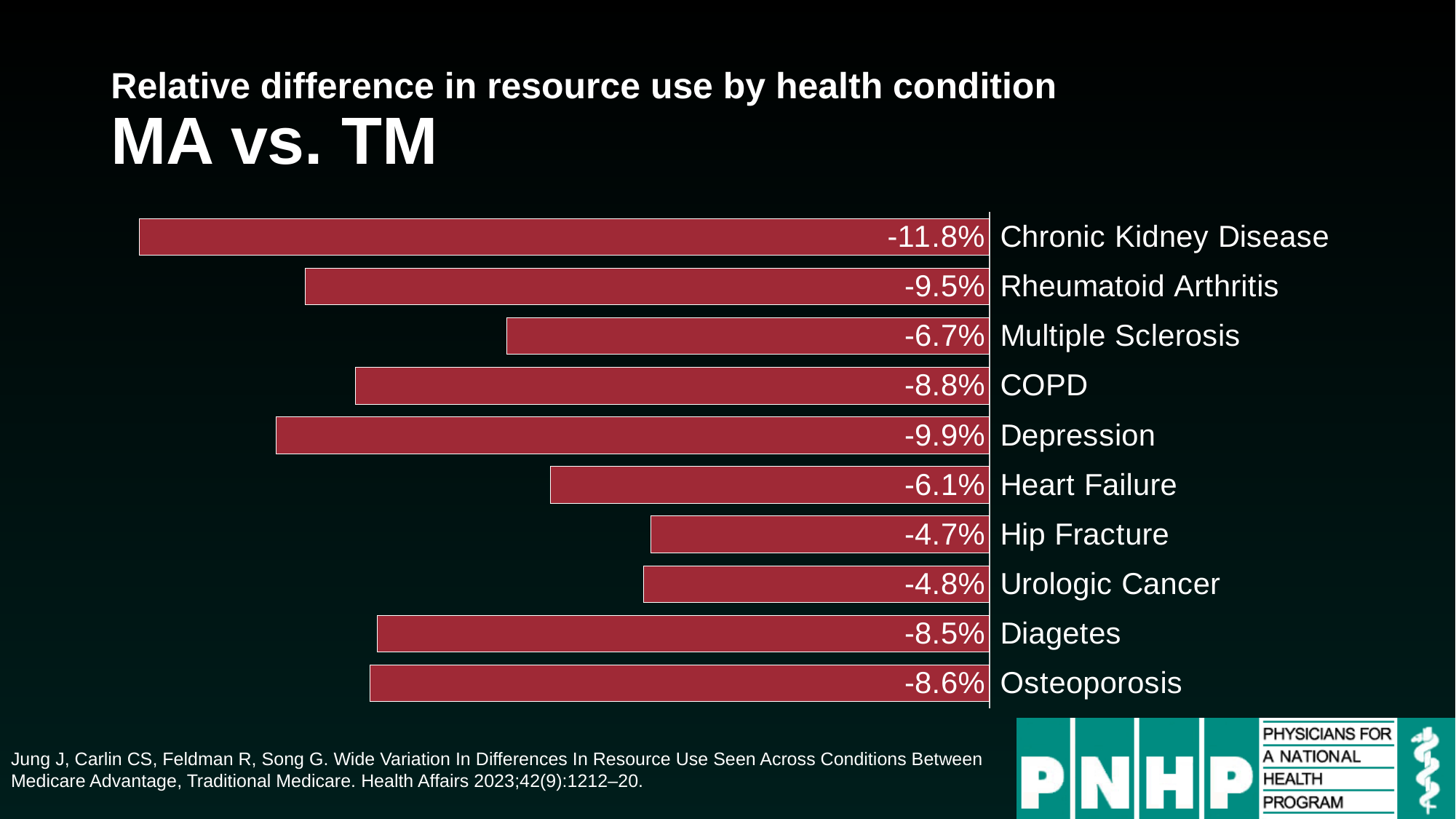
Which health condition has the smallest relative difference in magnitude (the shortest bar)? Hip Fracture Which health condition has the largest negative relative difference (the longest bar)? Chronic Kidney Disease How many health conditions are shown in the chart? 10 By how many percentage points does the value for Chronic Kidney Disease differ from the value for Rheumatoid Arthritis? 2.3 percentage points What value is shown for Depression? -9.9% By how many percentage points does the value for Depression differ from the value for Heart Failure? 3.8 percentage points What is the relative difference in resource use for Hip Fracture? -4.7% Which has the larger negative relative difference, COPD or Multiple Sclerosis? COPD What value is shown for Osteoporosis? -8.6% What is the relative difference in resource use for Chronic Kidney Disease? -11.8% What colour are the bars in the chart? Red What kind of chart is shown on the slide? Bar chart